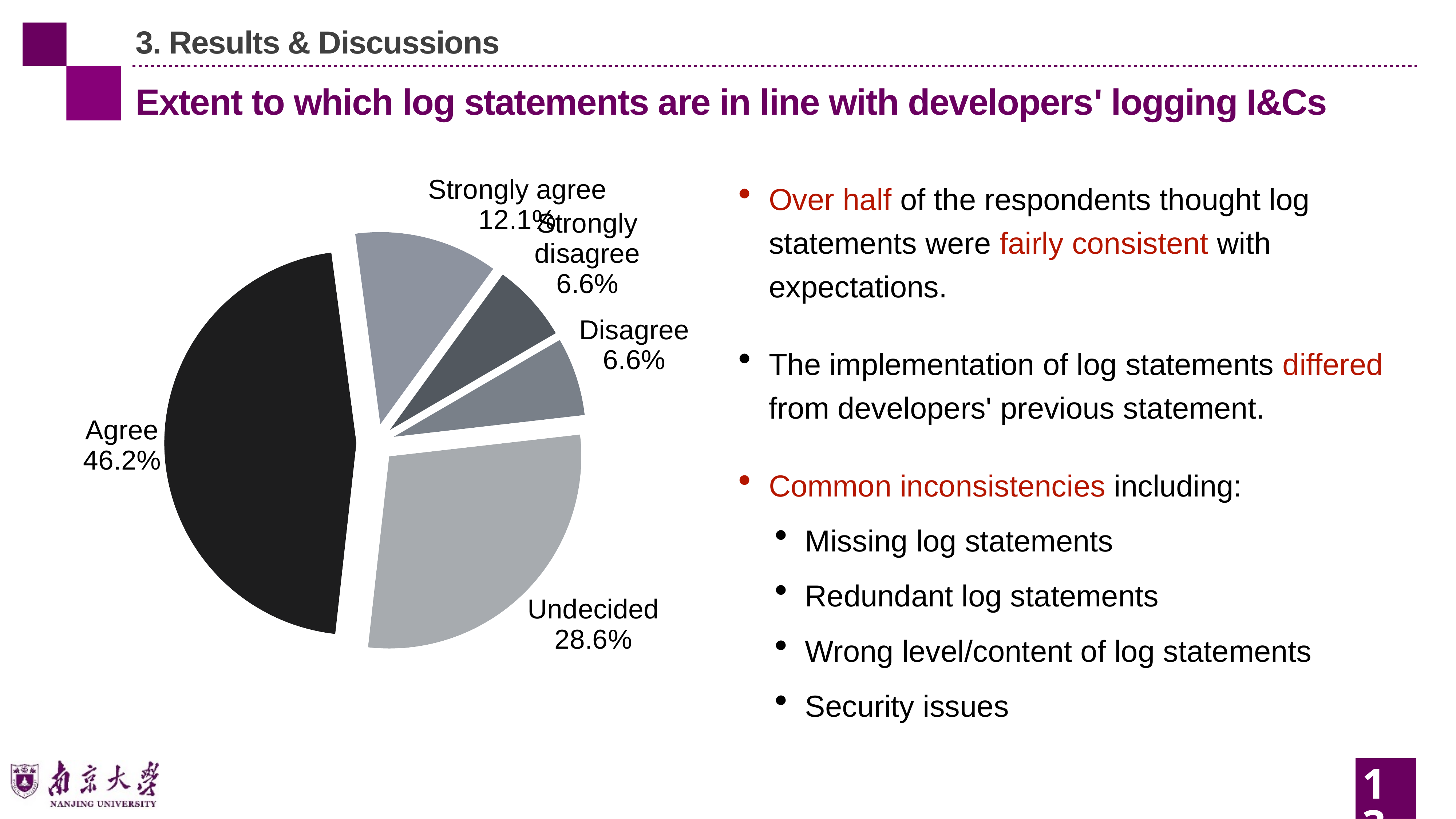
What is the difference in percentage points between Agree and Undecided? 17.6% Which is larger, the Undecided slice or the Strongly agree slice? Undecided What share of respondents chose Strongly agree? 12.1% What kind of chart is shown on the slide? pie chart What share of respondents chose Agree? 46.2% How many slices does the pie chart have? 5 Which category has the largest slice of the pie? Agree What is the difference in percentage points between Undecided and Strongly agree? 16.5% What is the title of the slide containing the pie chart? Extent to which log statements are in line with developers' logging I&Cs What share of respondents chose Disagree? 6.6%